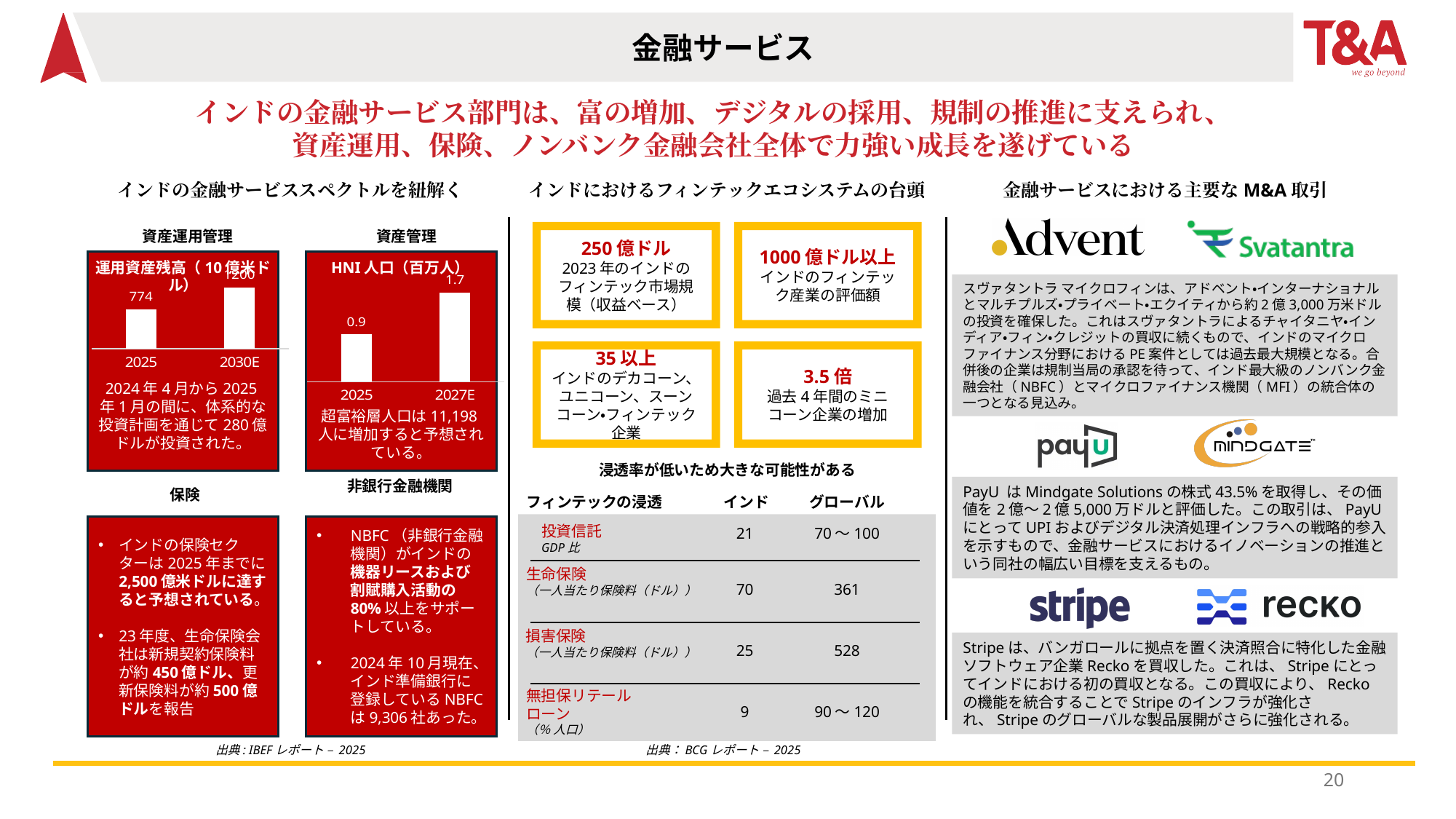
In the 資産運用管理 chart, which year has the higher bar, 2025 or 2030E? 2030E In the HNI 人口（百万人） chart, what is the difference between the 2027E and 2025 values? 0.8 In the HNI 人口（百万人） chart, which year has the highest value? 2027E In the HNI 人口（百万人） chart, how many categories are shown on the x axis? 2 What kind of chart is the 資産運用管理 chart? bar chart In the 資産運用管理 chart, how many bars are plotted? 2 In the 資産運用管理 chart, do the values rise or fall from 2025 to 2030E? rise In the 資産運用管理 chart, what is the value for 2025? 774 In the HNI 人口（百万人） chart, what is the value for 2025? 0.9 In the HNI 人口（百万人） chart, which year has the lowest value? 2025 In the HNI 人口（百万人） chart, what is the value for 2027E? 1.7 What is the title of the bar chart under the 資産管理 heading? HNI 人口（百万人）